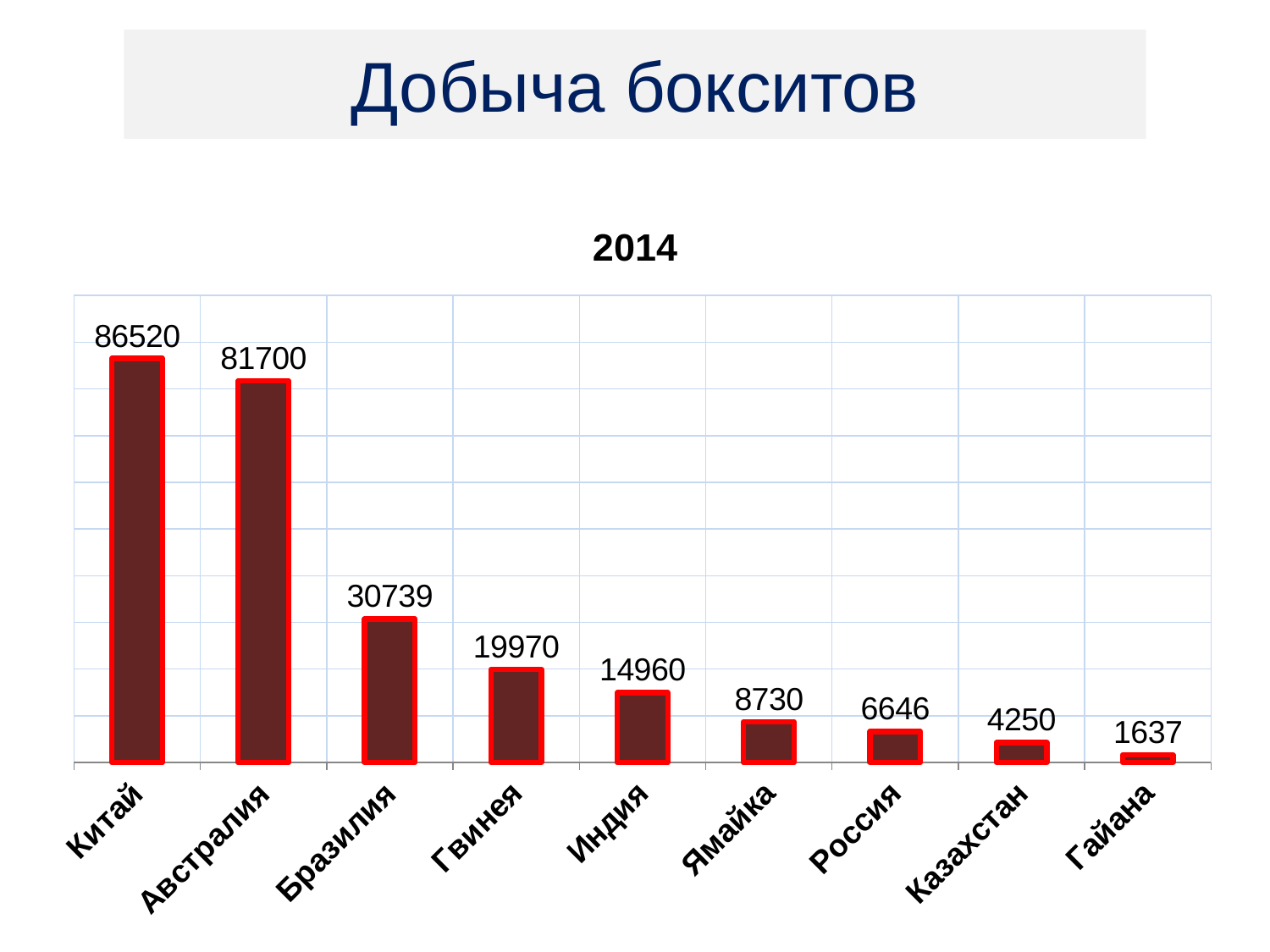
What is the title of the chart? 2014 What kind of chart is this? bar chart Which country has the lowest value? Гайана How many countries are shown on the chart? 9 What is the difference between the values for Гвинея and Индия? 5010 What is the value for Казахстан? 4250 Which is larger, the value for Ямайка or the value for Россия? Ямайка What is the value for Китай? 86520 Which country has the highest value? Китай What is the value for Бразилия? 30739 What is the difference between the values for Китай and Австралия? 4820 Do the values rise or fall from left to right along the x axis? fall